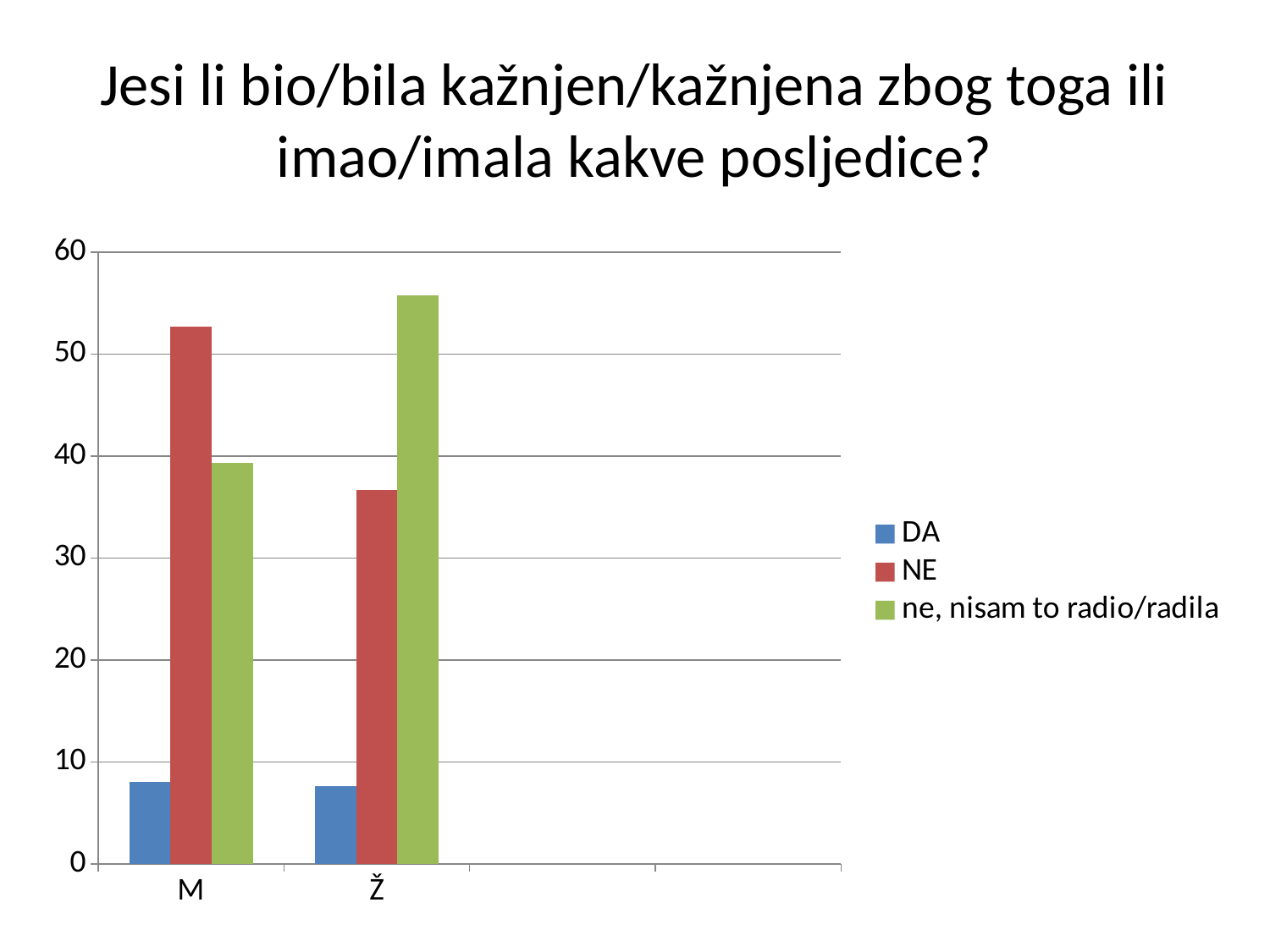
What kind of chart is shown on the slide? bar chart Which is larger: the NE value for M or the NE value for Ž? M Which series has the highest value for category Ž? ne, nisam to radio/radila Which series has the highest value for category M? NE Is the value for DA in category Ž greater or less than 10? less How many categories are shown on the x axis? 2 Which series has the lowest value for category Ž? DA Which series has the lowest value for category M? DA What colour represents the series NE in the legend? red How many series does the legend list? 3 Is the value for NE in category M greater or less than 50? greater